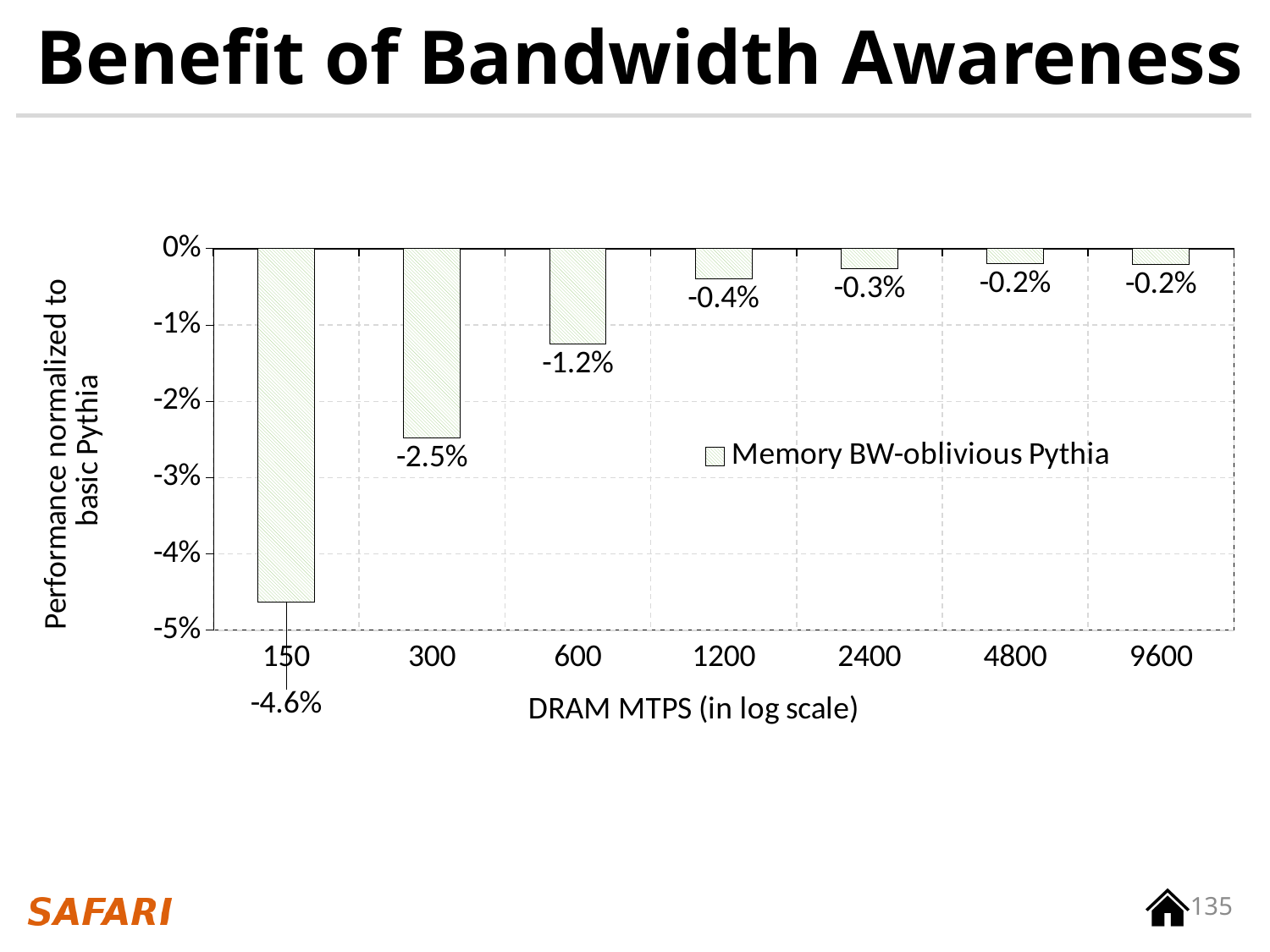
How many DRAM MTPS categories are shown on the x axis? 7 What is the value for DRAM MTPS 2400? -0.3% What is the series name shown in the legend? Memory BW-oblivious Pythia Which DRAM MTPS category has the lowest (most negative) value? 150 What is the difference between the values for DRAM MTPS 150 and 300? 2.1% How many series does the legend list? 1 What is the value for DRAM MTPS 600? -1.2% What is the value for DRAM MTPS 9600? -0.2% What kind of chart is shown on the slide? Bar chart What is the value for DRAM MTPS 150? -4.6% What is the difference between the values for DRAM MTPS 600 and 1200? 0.8% Which has the larger (less negative) value, DRAM MTPS 300 or 600? 600